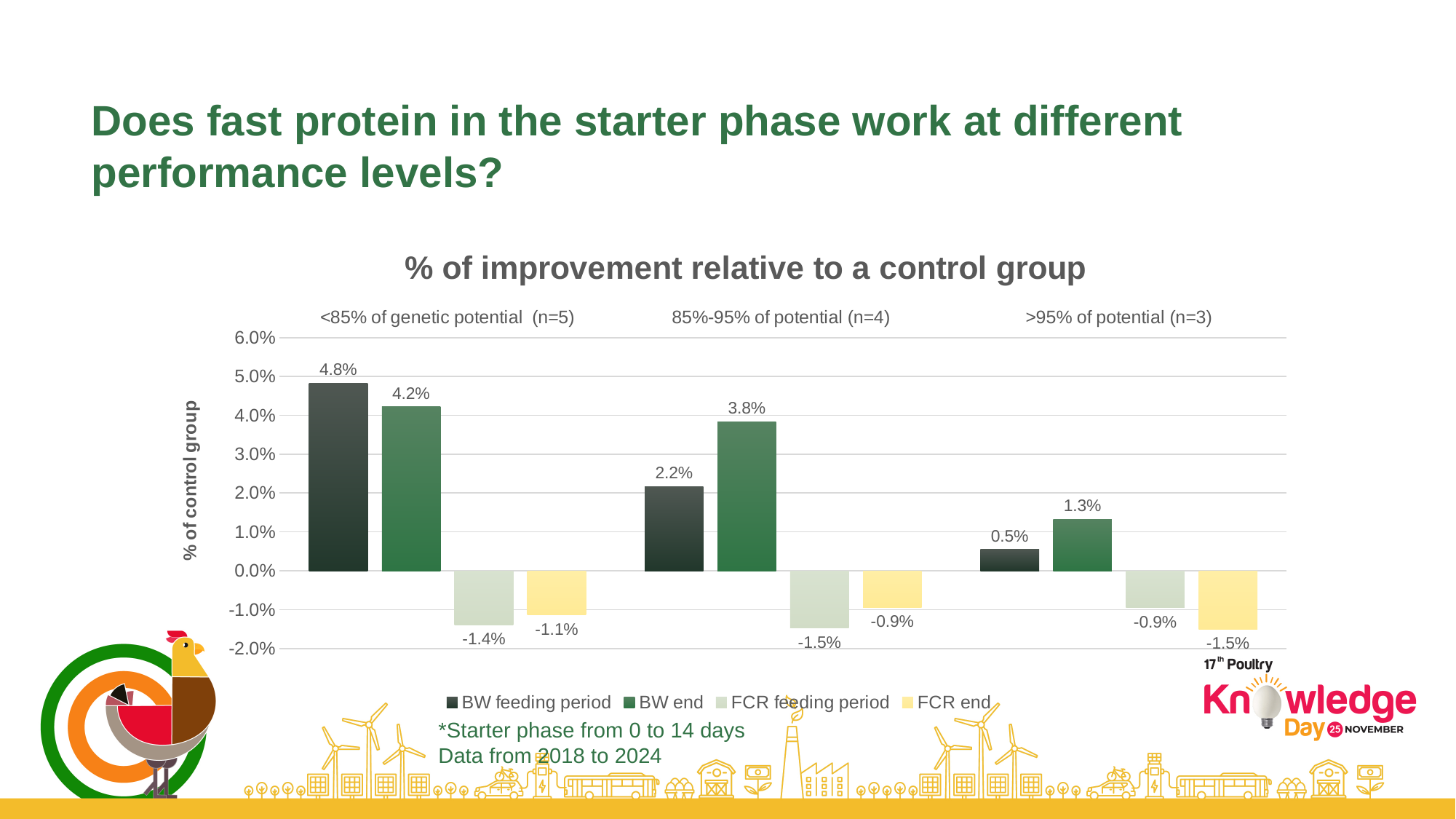
What is the BW feeding period value for the <85% of genetic potential (n=5) group? 4.8% What kind of chart is shown on the slide? Bar chart What is the FCR end value for the >95% of potential (n=3) group? -1.5% How many series does the legend list? 4 What is the FCR feeding period value for the <85% of genetic potential (n=5) group? -1.4% Which group has the lowest BW end value? >95% of potential (n=3) Which group has the highest BW feeding period value? <85% of genetic potential (n=5) Which is larger for the >95% of potential (n=3) group: BW feeding period or BW end? BW end What is the title of the chart? % of improvement relative to a control group What is the BW end value for the 85%-95% of potential (n=4) group? 3.8% How many performance-level groups are shown on the x axis? 3 What is the difference between the BW feeding period value and the BW end value for the 85%-95% of potential (n=4) group? 1.6%